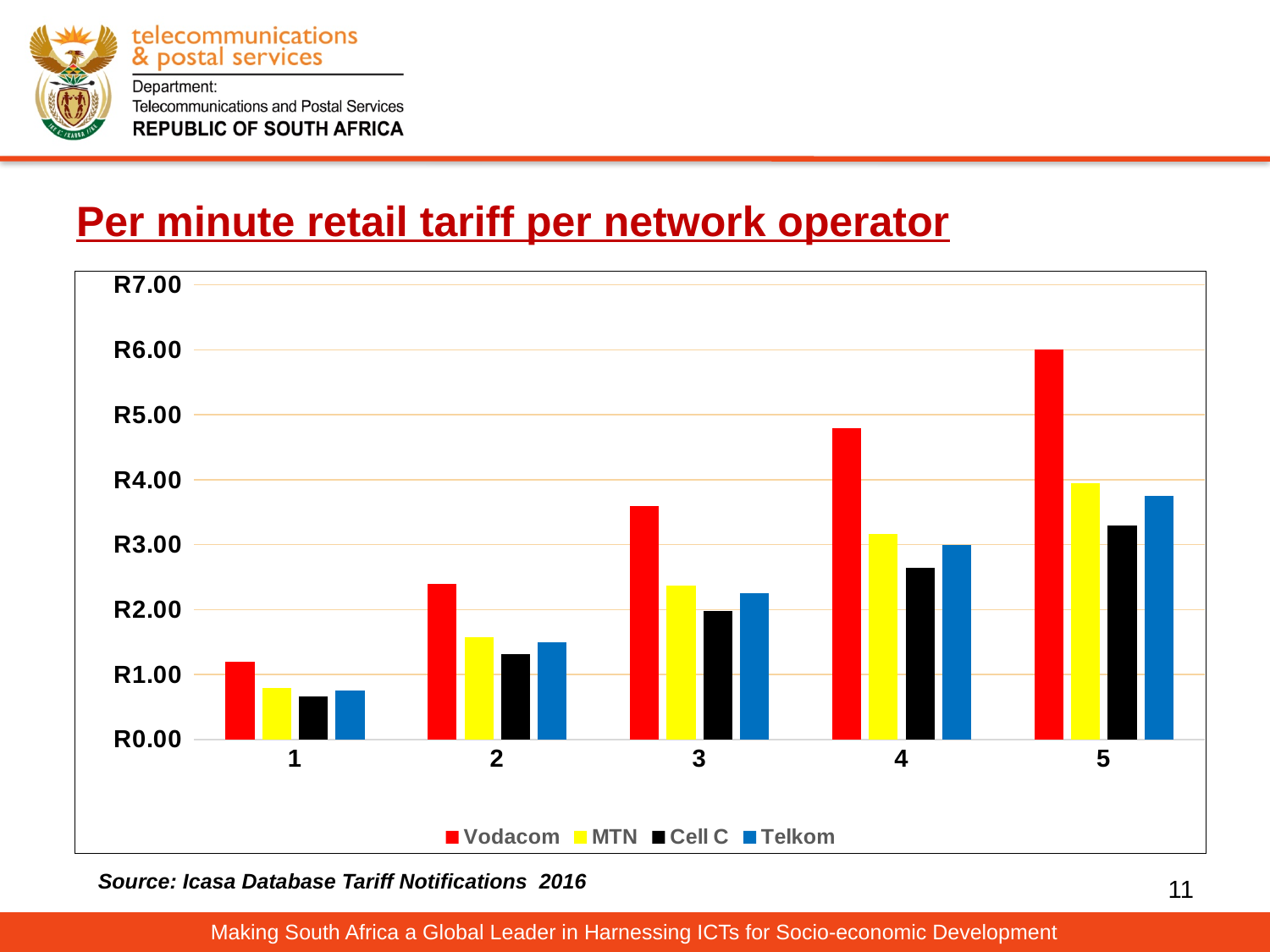
What kind of chart is shown on the slide? bar chart Is the value for Cell C in category 1 greater or less than R1.00? less How many categories are shown along the x axis? 5 Which is larger in category 4, the value for MTN or the value for Cell C? MTN Which network operator has the lowest per minute retail tariff in category 3? Cell C Which network operator has the highest per minute retail tariff in category 5? Vodacom Is the value for Vodacom in category 4 greater or less than R4.00? greater Is the value for MTN in category 2 greater or less than R2.00? less Do the Vodacom values rise or fall from category 1 to category 5? rise What is the title of the chart? Per minute retail tariff per network operator How many series does the legend list? 4